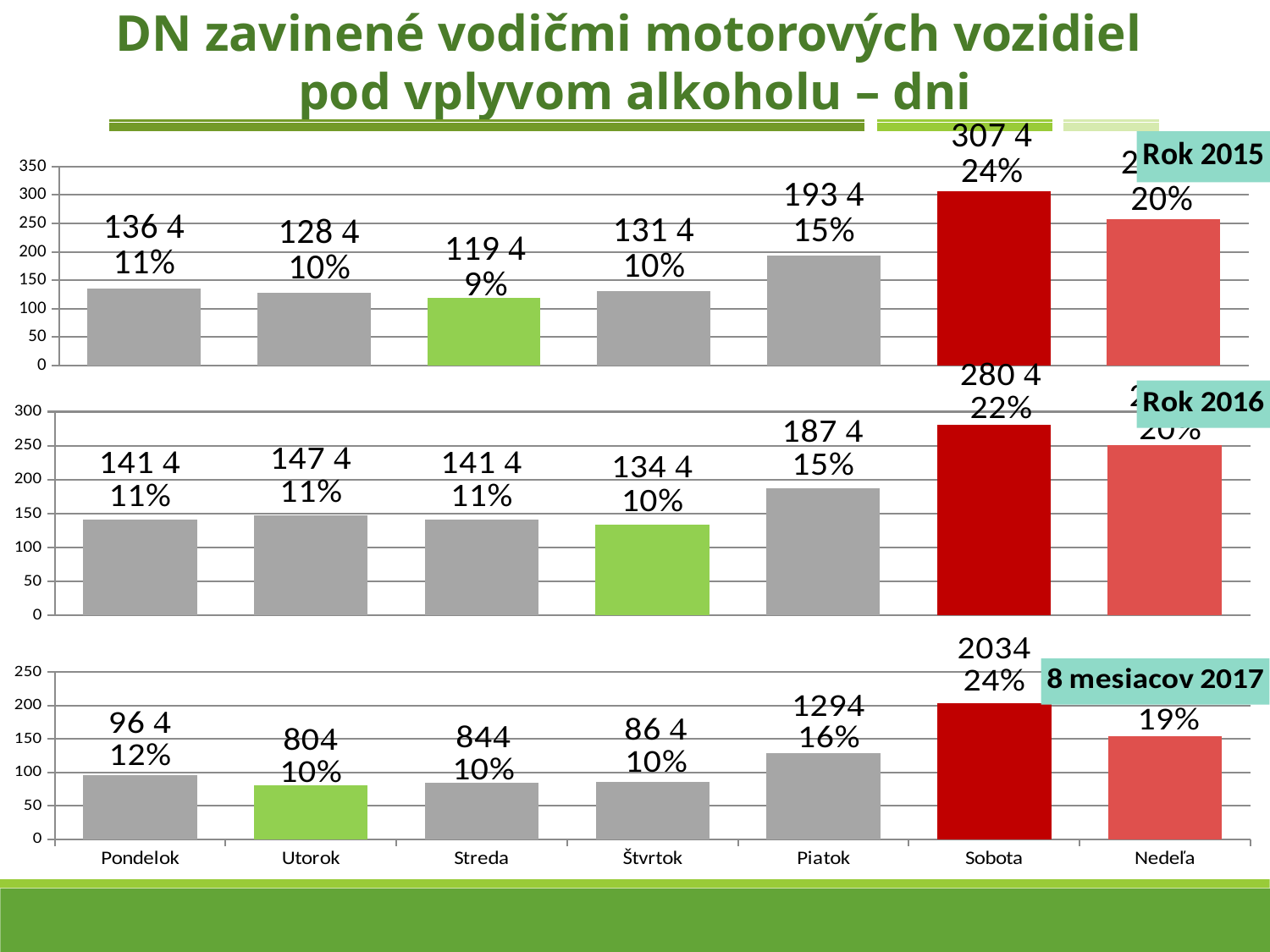
What kind of chart is used for the Rok 2015 data? bar chart In the Rok 2015 chart, how many percentage points higher is Sobota's share than Nedeľa's share? 4 percentage points In the Rok 2016 chart, which is larger, the value for Piatok or the value for Sobota? Sobota In the Rok 2015 chart, which day has the lowest value? Streda In the Rok 2016 chart, is the value for Sobota greater or less than 250? greater In the Rok 2015 chart, what percentage is shown for Piatok? 15% In the Rok 2016 chart, what percentage is shown for Sobota? 22% In the 8 mesiacov 2017 chart, which day has the highest value? Sobota In the Rok 2016 chart, which day has the lowest value? Štvrtok How many days (categories) are shown on the x axis of the 8 mesiacov 2017 chart? 7 In the 8 mesiacov 2017 chart, what percentage is shown for Piatok? 16% In the Rok 2015 chart, what percentage is shown for Sobota? 24%